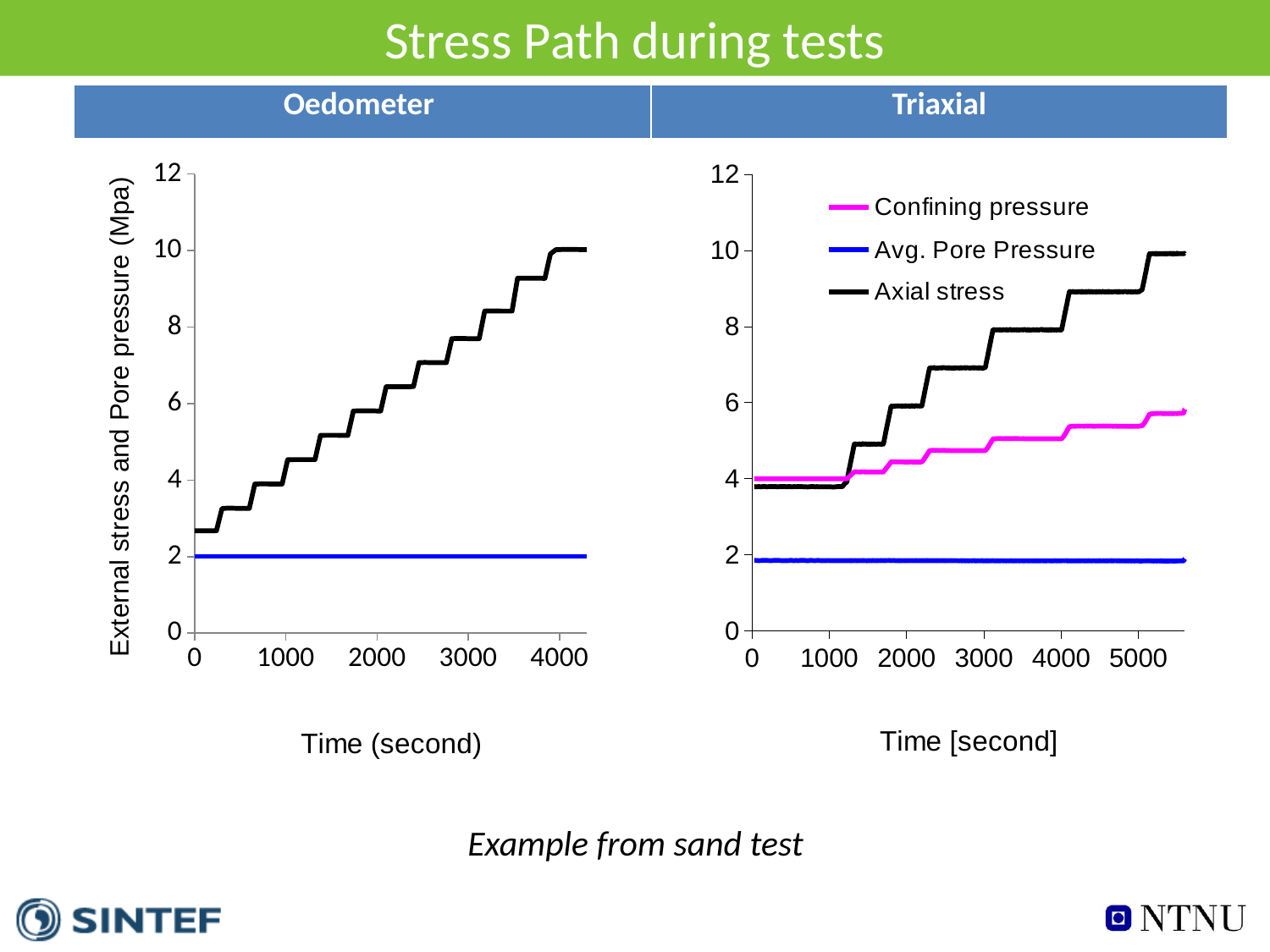
In the Triaxial chart, is the Avg. Pore Pressure greater or less than 4 throughout the test? less In the Triaxial chart, does the Axial stress rise or fall as time increases? rise In the Oedometer chart, is the black stress line at 4000 seconds greater or less than 8? greater In the Triaxial chart, is the Confining pressure at 5000 seconds greater or less than 6? less In the Triaxial chart, which series is drawn in magenta? Confining pressure What is the y-axis label of the Oedometer chart? External stress and Pore pressure (Mpa) In the Triaxial chart, which is larger at 3000 seconds, the Axial stress or the Confining pressure? Axial stress How many series does the legend of the Triaxial chart list? 3 What kind of chart is the Oedometer chart on the left? line chart In the Oedometer chart, does the black stress line rise or fall along the time axis? rise